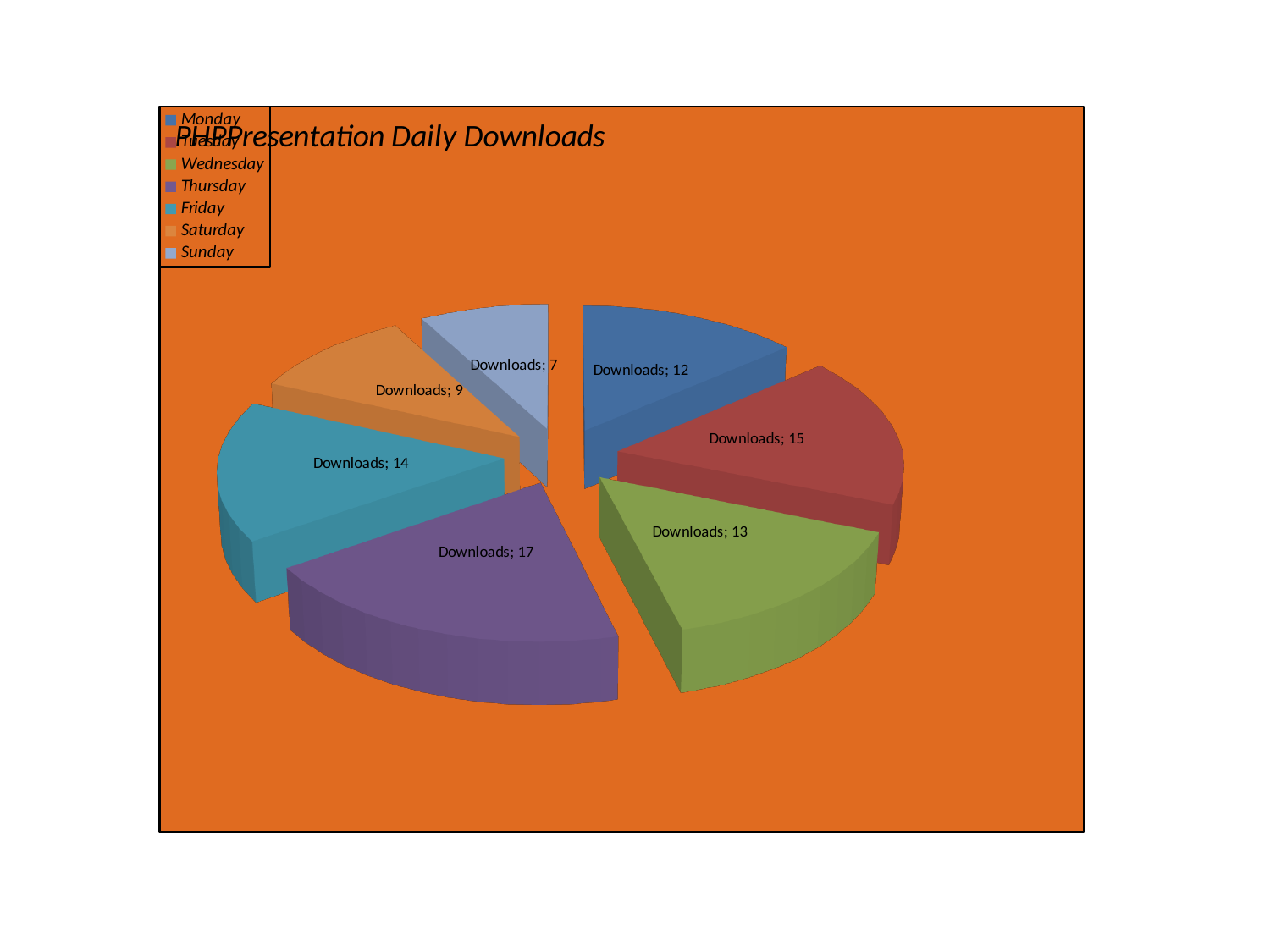
What kind of chart is shown on the slide? Pie chart How many categories does the legend list? 7 Which has more downloads, Tuesday or Wednesday? Tuesday What is the Downloads value for Monday? 12 What is the Downloads value for Friday? 14 Which day has the lowest number of downloads? Sunday Which day has the highest number of downloads? Thursday What is the Downloads value for Thursday? 17 What is the difference in downloads between Thursday and Sunday? 10 What is the total number of downloads across all seven days? 87 What is the Downloads value for Sunday? 7 What is the title of the chart? PHPPresentation Daily Downloads